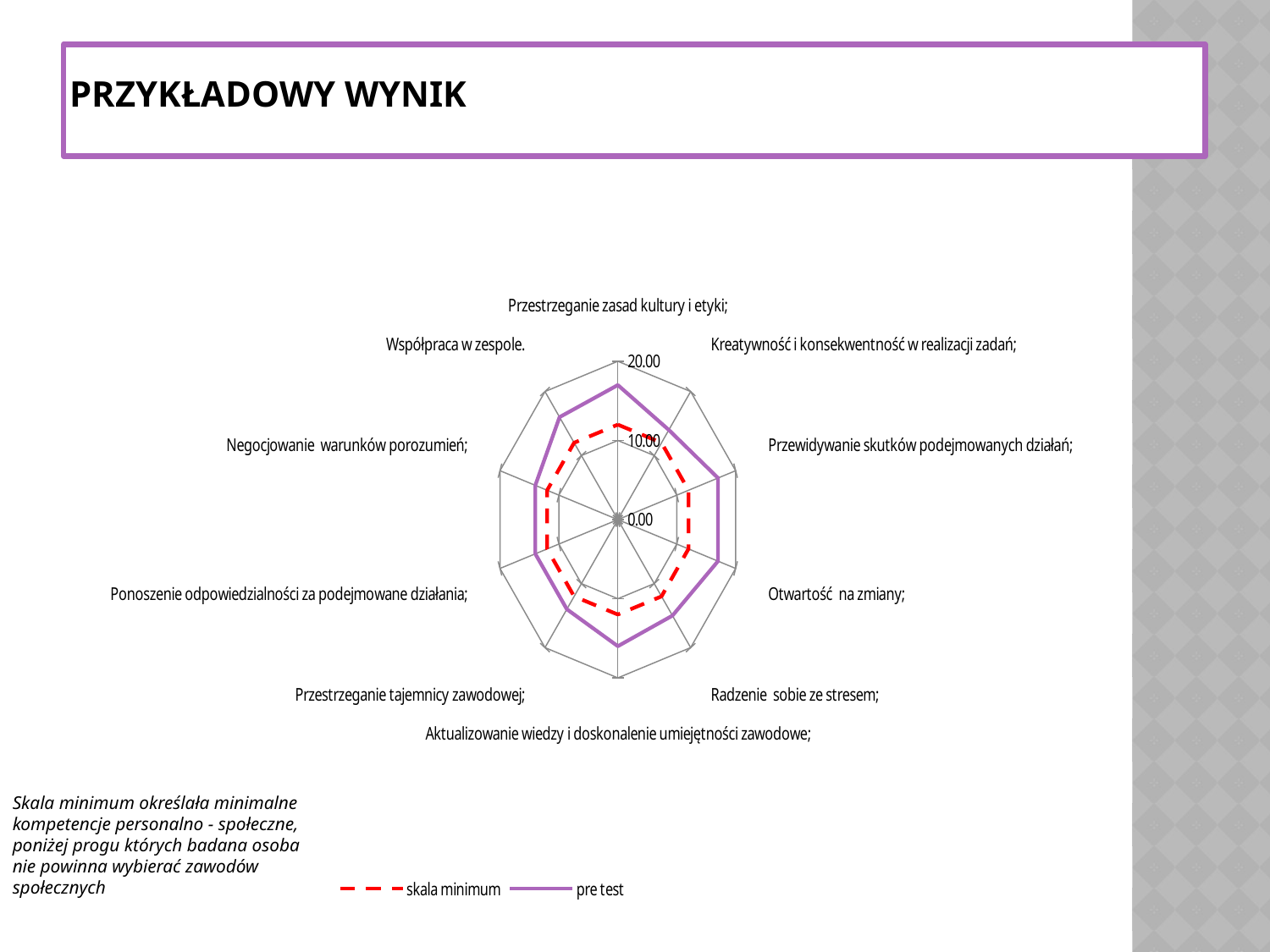
What kind of chart is shown on the slide? radar chart Is the pre test value for Otwartość na zmiany greater or less than 10.00? greater Is the pre test value for Przestrzeganie zasad kultury i etyki greater or less than 10.00? greater What is the highest value marked on the radar chart's axis scale? 20.00 Is the pre test value for Współpraca w zespole greater or less than 20.00? less What are the two series named in the chart legend? skala minimum and pre test For Radzenie sobie ze stresem, which series has the larger value: skala minimum or pre test? pre test Which series is drawn as a red dashed line? skala minimum For Przewidywanie skutków podejmowanych działań, which series has the larger value: skala minimum or pre test? pre test How many series does the legend of the chart list? 2 How many categories (axes) does the radar chart have? 10